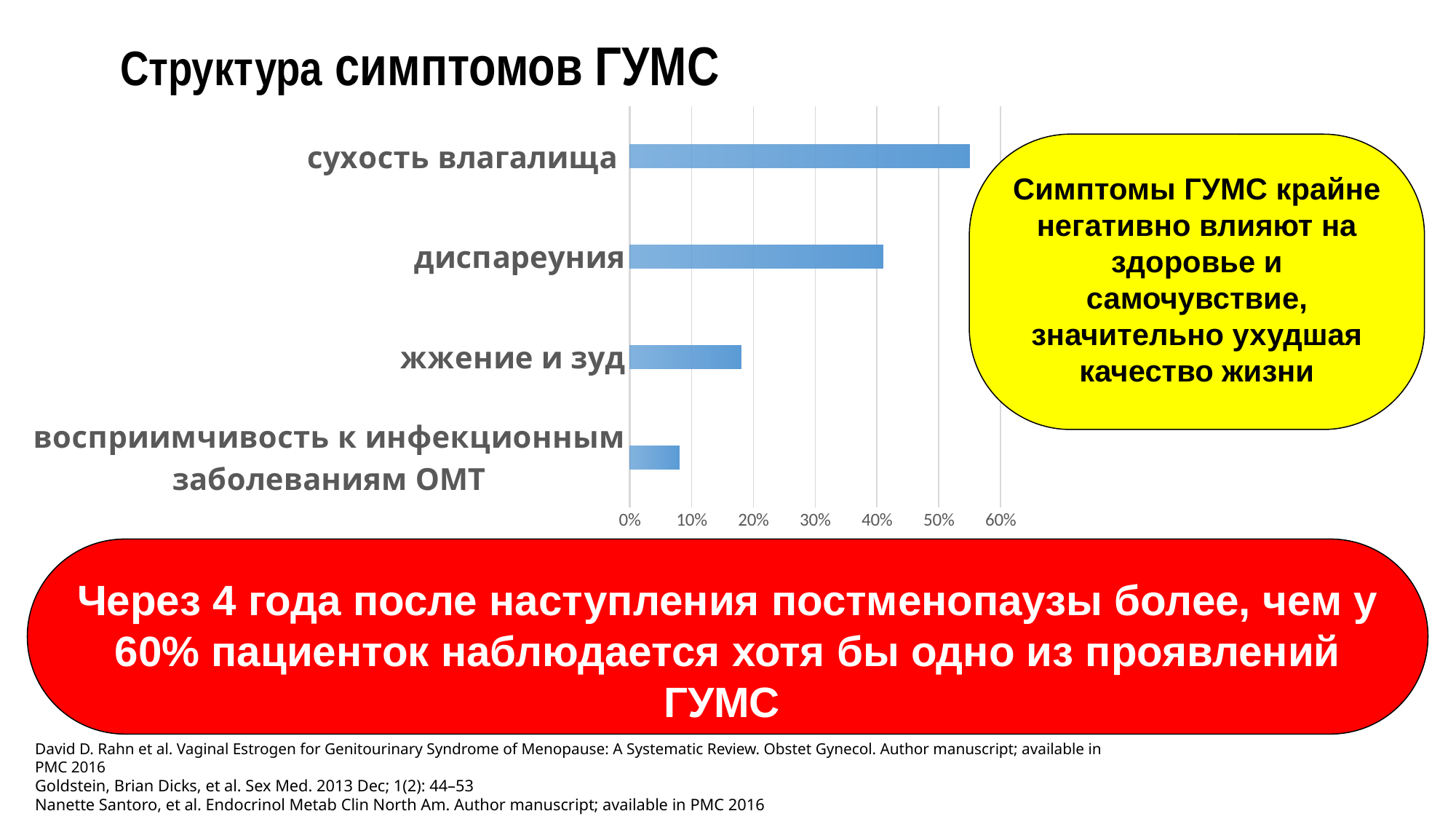
What is the title of the chart on the slide? Структура симптомов ГУМС Which symptom has the highest value in the chart? сухость влагалища Is the value for сухость влагалища greater or less than 50%? greater What kind of chart is shown on the slide? bar chart Which is larger: the value for сухость влагалища or the value for диспареуния? сухость влагалища Which symptom has the lowest value in the chart? восприимчивость к инфекционным заболеваниям ОМТ Which is larger: the value for диспареуния or the value for жжение и зуд? диспареуния How many categories (symptoms) are plotted in the chart? 4 Is the value for жжение и зуд greater or less than 10%? greater Is the value for восприимчивость к инфекционным заболеваниям ОМТ greater or less than 10%? less What is the maximum value shown on the chart's horizontal axis? 60%